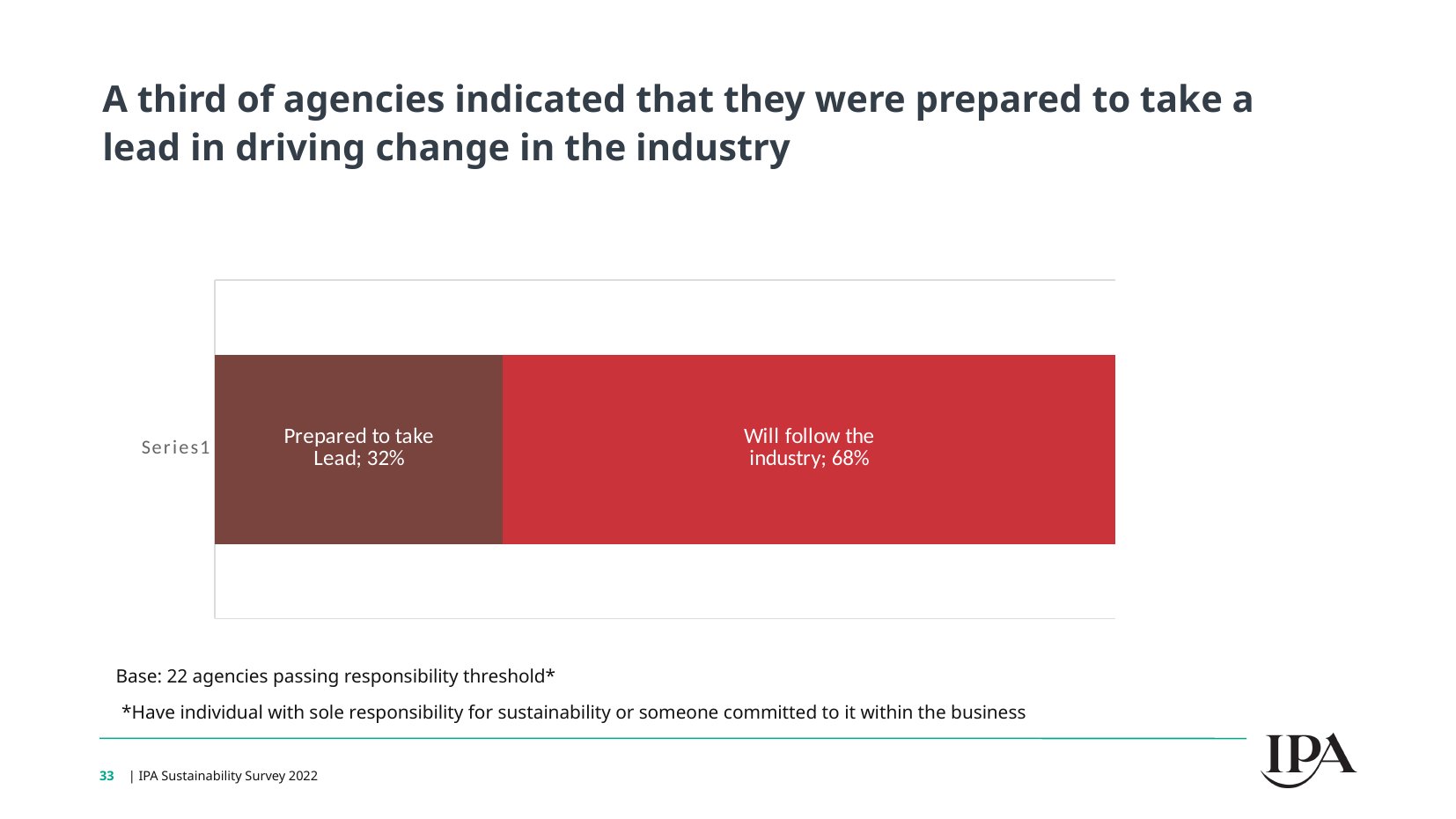
Which segment has the highest value? Will follow the industry How many segments make up the stacked bar? 2 Which segment of the bar is larger, "Prepared to take Lead" or "Will follow the industry"? Will follow the industry What kind of chart is shown on the slide? Stacked bar chart What is the difference in percentage points between "Will follow the industry" and "Prepared to take Lead"? 36 What percentage of agencies are shown as "Prepared to take Lead"? 32% What is the total of the two segments in the stacked bar? 100% Which segment has the lowest value? Prepared to take Lead What label appears on the category axis of the chart? Series1 What percentage of agencies are shown as "Will follow the industry"? 68% What colour is the "Will follow the industry" segment? Red